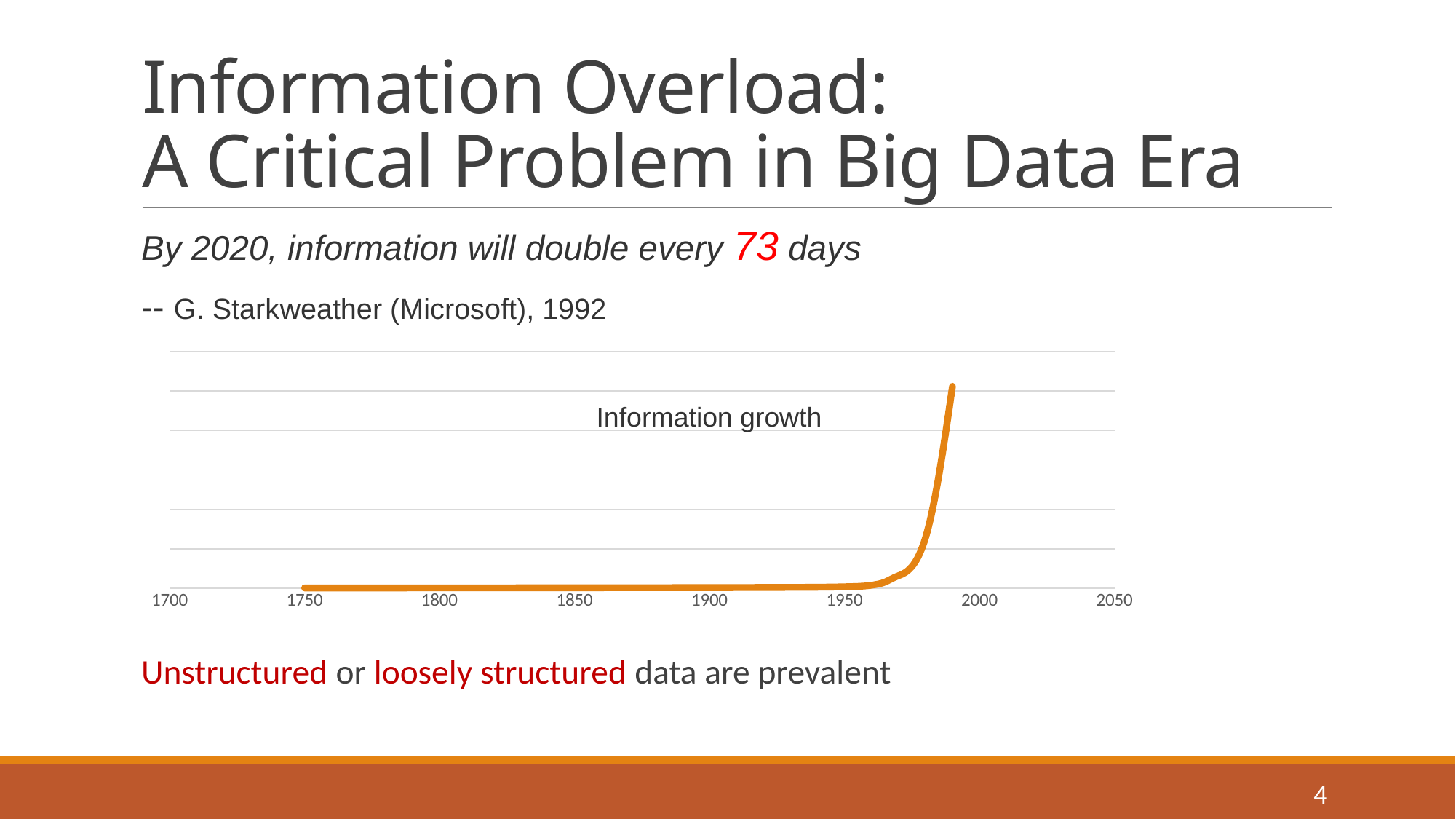
Do the values in the chart rise or fall as the years increase along the x axis? rise What is the last year label shown on the x axis? 2050 How many lines (series) are plotted in the chart? 1 How many year labels are shown on the x axis? 8 What kind of chart is shown on the slide? line chart What is the title of the chart? Information growth What is the first year label shown on the x axis? 1700 Is the value of the line higher around 1990 or around 1800? around 1990 Is the value of the line higher around 1850 or around 1980? around 1980